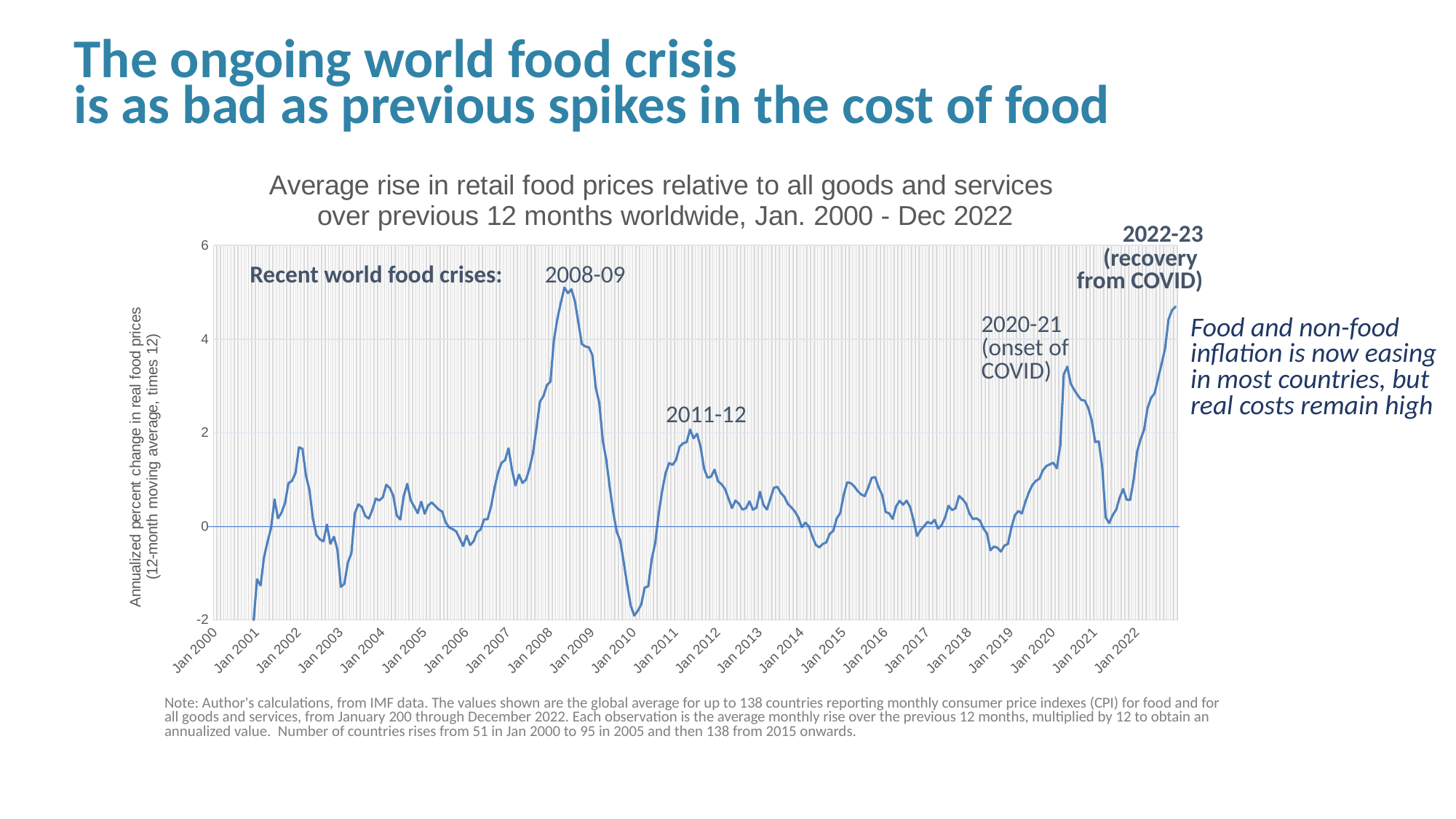
What kind of chart is shown on the slide? line chart Is the peak value during the 2008-09 crisis greater or less than 4? greater Which of the labelled food crises has the highest peak on the chart? 2008-09 Is the value at the end of 2022 greater or less than 4? greater Is the peak value during the 2020-21 crisis greater or less than 4? less Does the line rise or fall between Jan 2021 and the end of 2022? rise How many data series are plotted in the chart? 1 Which is larger: the peak of the 2008-09 crisis or the peak of the 2011-12 crisis? 2008-09 What is the title of the chart? Average rise in retail food prices relative to all goods and services over previous 12 months worldwide, Jan. 2000 - Dec 2022